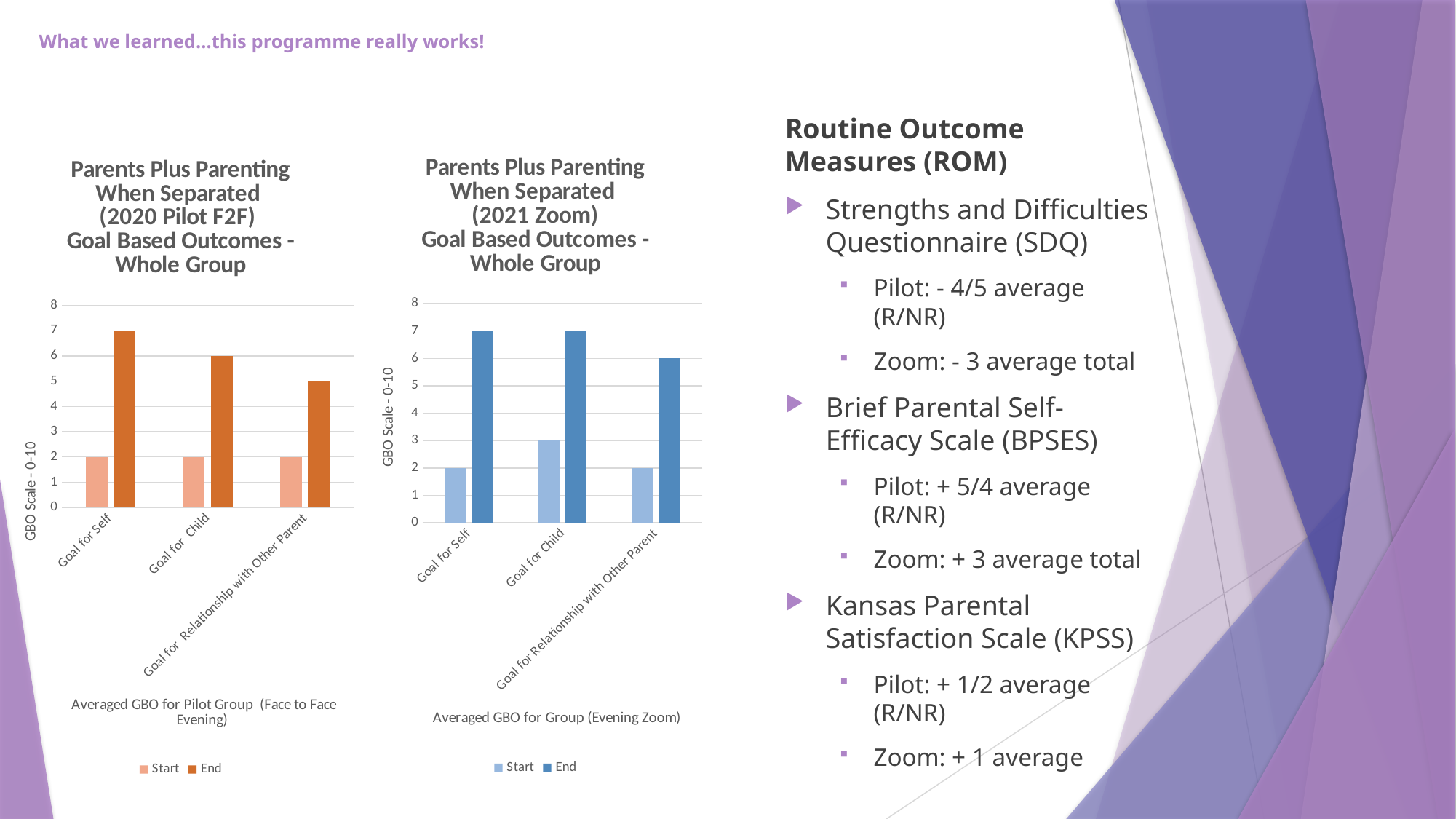
In the 2021 Zoom chart, what is the Start value for Goal for Child? 3 What type of chart is the 2021 Zoom chart? bar chart In the 2021 Zoom chart, is the End value for Goal for Self larger or smaller than the End value for Goal for Relationship with Other Parent? larger In the 2021 Zoom chart, which category has the lowest End value? Goal for Relationship with Other Parent In the 2020 Pilot F2F chart, what is the difference between the End and Start values for Goal for Child? 4 What is the y-axis label of the 2020 Pilot F2F chart? GBO Scale - 0-10 How many categories are shown on the x axis of the 2020 Pilot F2F chart? 3 In the 2021 Zoom chart, is the End value for Goal for Child greater or less than 5? greater In the 2020 Pilot F2F chart, which category has the highest End value? Goal for Self In the 2020 Pilot F2F chart, what is the End value for Goal for Self? 7 How many series does the legend of the 2021 Zoom chart list? 2 In the 2020 Pilot F2F chart, what is the End value for Goal for Relationship with Other Parent? 5